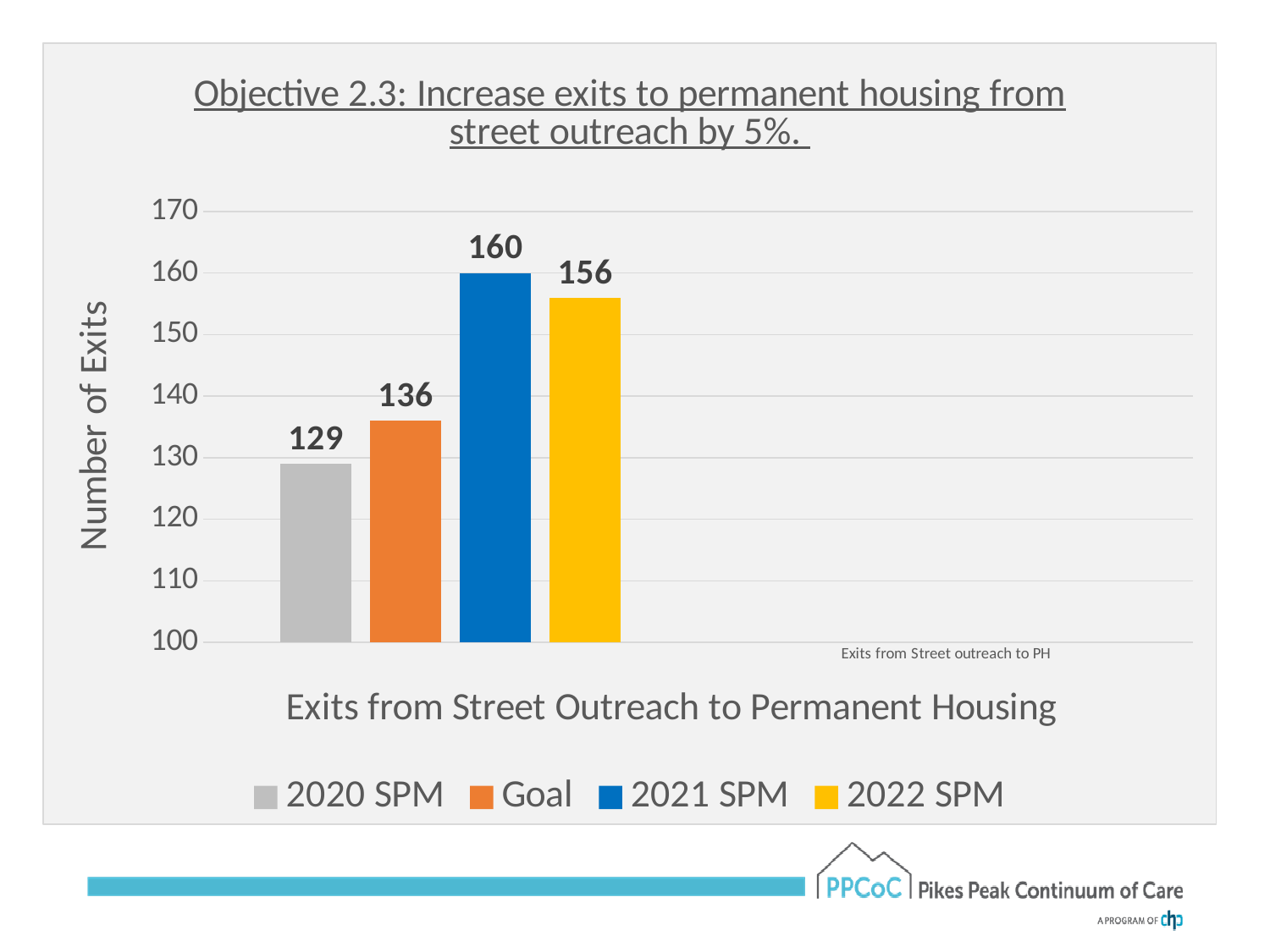
What is the difference between the Goal value and the 2020 SPM value? 7 Which series has the highest value? 2021 SPM What is the value for 2021 SPM? 160 What is the difference between the 2021 SPM value and the 2022 SPM value? 4 Is the value for 2020 SPM greater or less than 130? less What is the value for the Goal series? 136 What kind of chart is shown on the slide? bar chart What is the value for 2020 SPM? 129 Which is larger, the 2022 SPM value or the Goal value? 2022 SPM How many series does the legend list? 4 Which series has the lowest value? 2020 SPM What is the value for 2022 SPM? 156